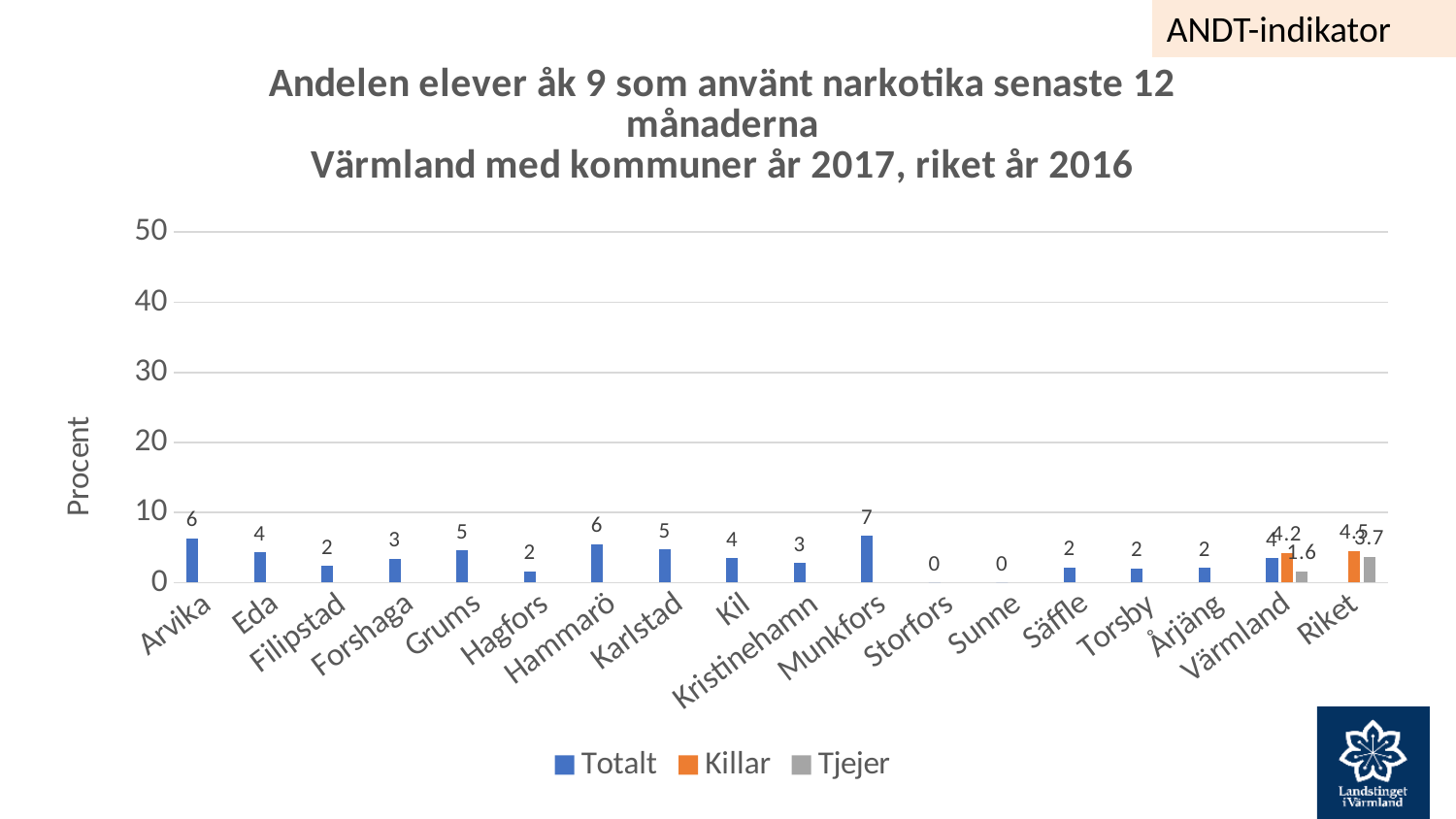
Which municipality has the highest Totalt value? Munkfors What kind of chart is shown on the slide? bar chart What is the difference between the Totalt values for Arvika and Eda? 2 Is the Totalt value for Munkfors greater or less than 10? less What is the Totalt value for Munkfors? 7 What is the Killar value for Värmland? 4.2 What is the Tjejer value for Riket? 3.7 How many series does the legend list? 3 How many categories are shown on the x axis? 18 Which has a larger Totalt value, Grums or Forshaga? Grums What is the Totalt value for Arvika? 6 What is the Tjejer value for Värmland? 1.6